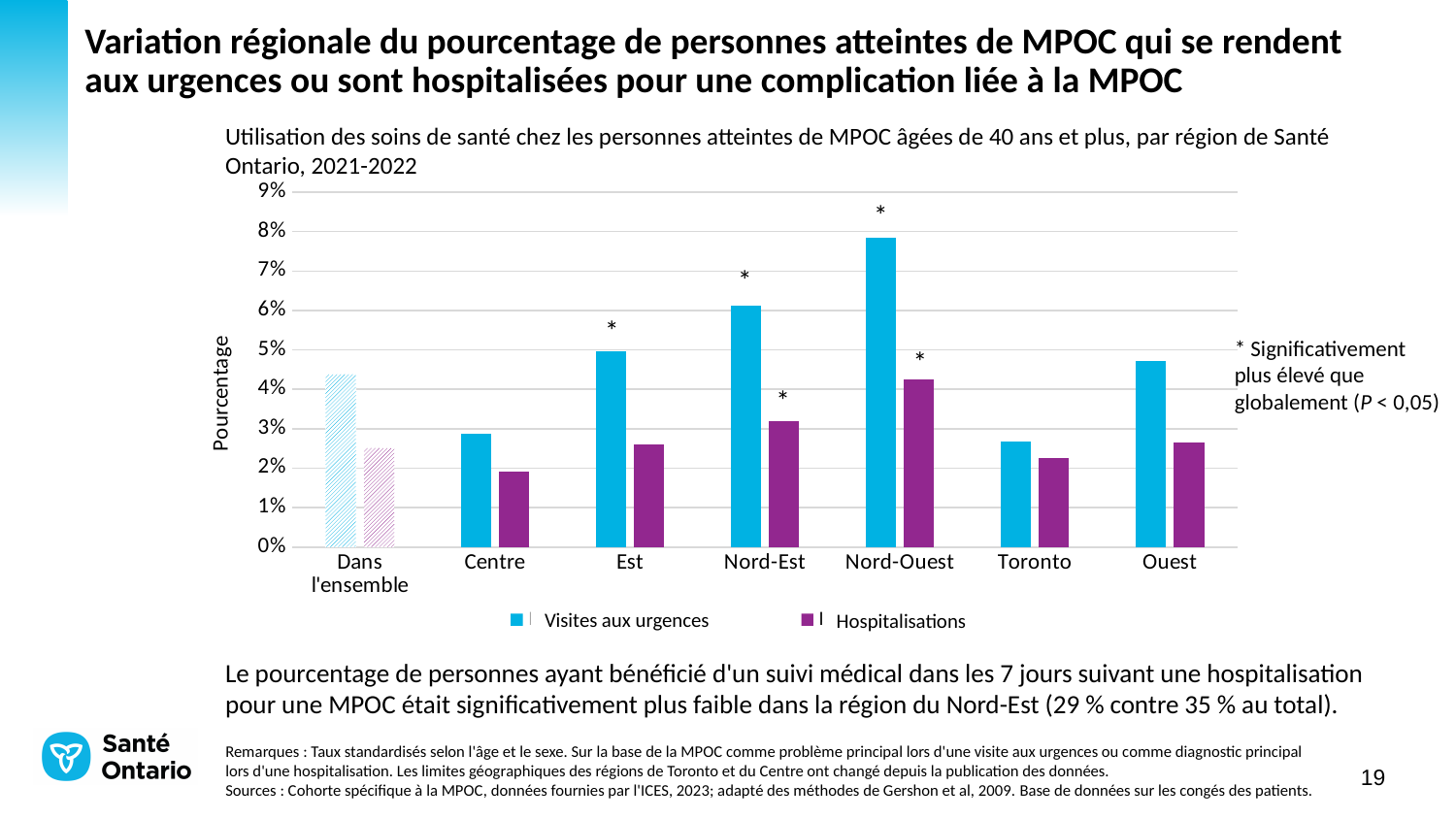
Which region has the highest value for Hospitalisations? Nord-Ouest Which is larger: Visites aux urgences in Nord-Est or Visites aux urgences in Ouest? Nord-Est What is the label of the y axis? Pourcentage Which region has the lowest value for Hospitalisations? Centre What kind of chart is shown on the slide? bar chart How many series does the legend list? 2 Is the value for Hospitalisations in Centre greater or less than 2%? less Which region has the highest value for Visites aux urgences? Nord-Ouest How many regions (categories) are shown on the x axis, including 'Dans l'ensemble'? 7 Is the value for Visites aux urgences in Nord-Ouest greater or less than 7%? greater Is the value for Visites aux urgences in Nord-Est greater or less than 5%? greater Which is larger: Hospitalisations in Nord-Ouest or Hospitalisations in Toronto? Nord-Ouest